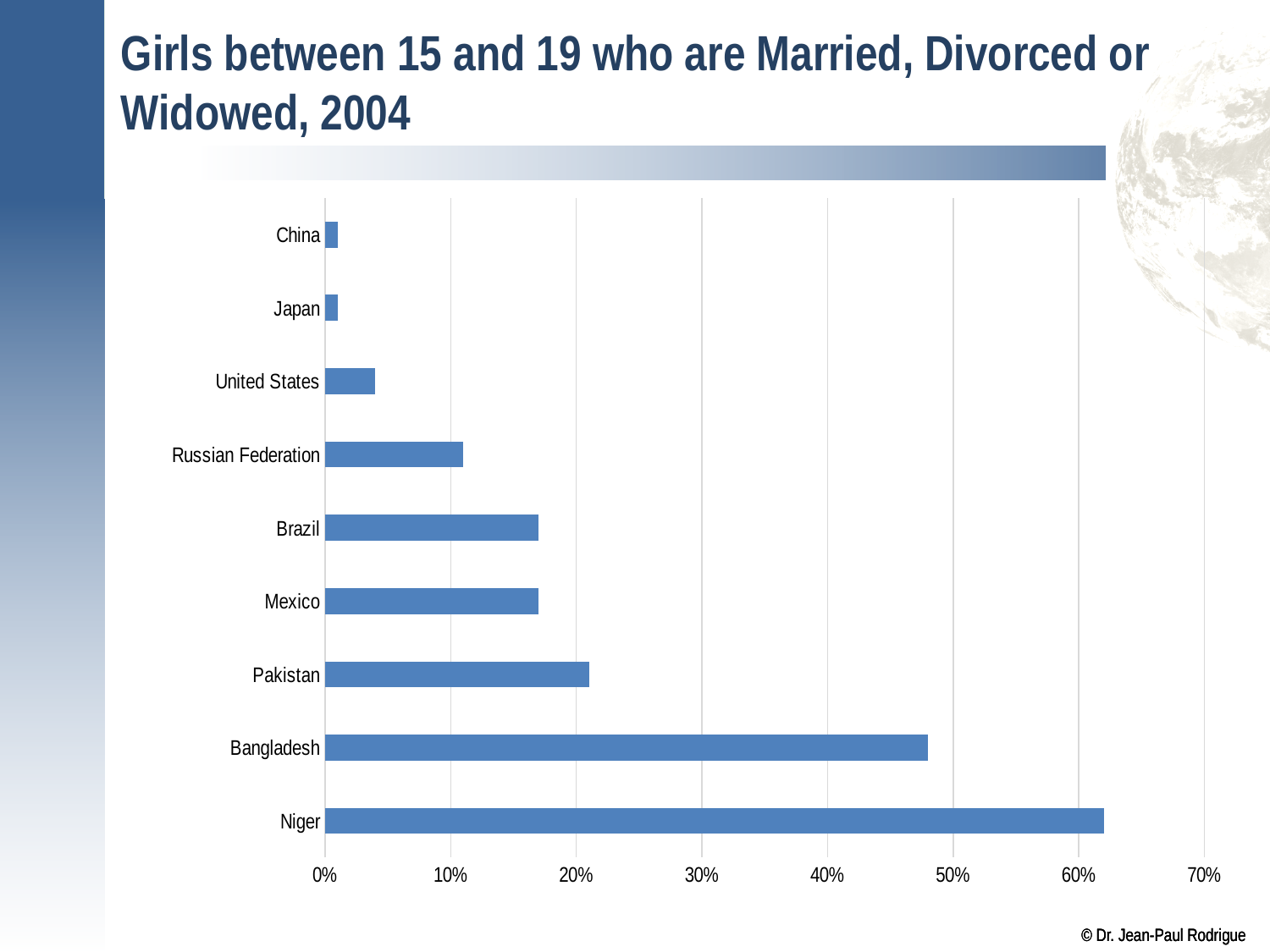
What kind of chart is shown on the slide? bar chart Is the value for Pakistan greater or less than 20%? greater Which has a larger value, the Russian Federation or the United States? Russian Federation Is the value for the Russian Federation greater or less than 10%? greater Which country has the highest value in the chart? Niger Which has a larger value, Bangladesh or Pakistan? Bangladesh Is the value for the United States greater or less than 10%? less Do the values rise or fall going down the chart from China to Niger? rise What is the title of the chart on the slide? Girls between 15 and 19 who are Married, Divorced or Widowed, 2004 How many countries are shown in the chart? 9